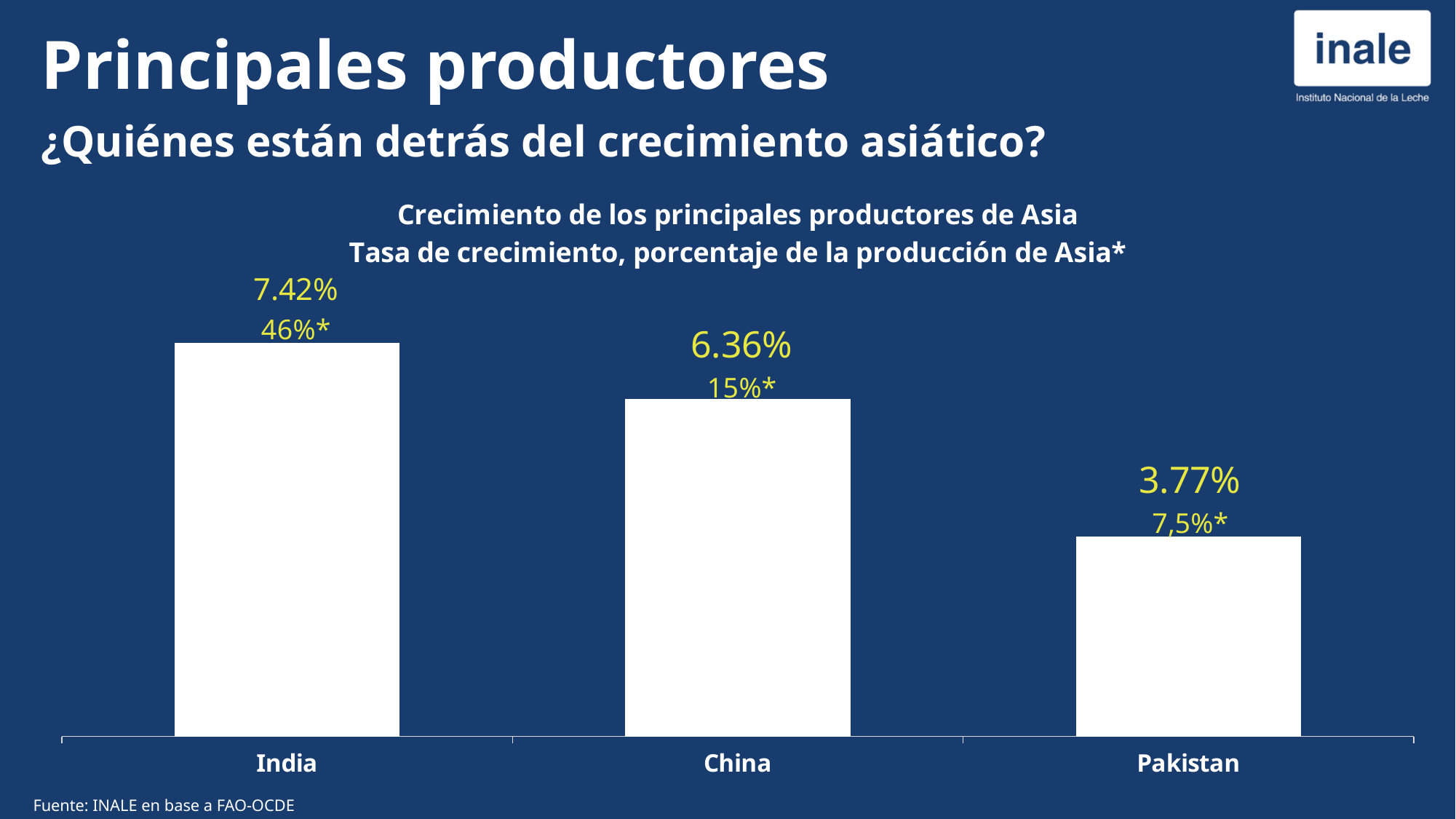
What is the growth rate shown for India? 7.42% What is the difference between India's and China's growth rates? 1.06% What is the difference between China's and Pakistan's growth rates? 2.59% How many countries are shown in the chart? 3 Which country has the lowest growth rate? Pakistan What percentage of Asia's production is attributed to Pakistan (the asterisked label)? 7,5%* Which has a higher growth rate, China or Pakistan? China What percentage of Asia's production is attributed to India (the asterisked label)? 46%* Which country has the highest growth rate? India What is the growth rate shown for China? 6.36% What type of chart is shown on the slide? Bar chart What is the growth rate shown for Pakistan? 3.77%